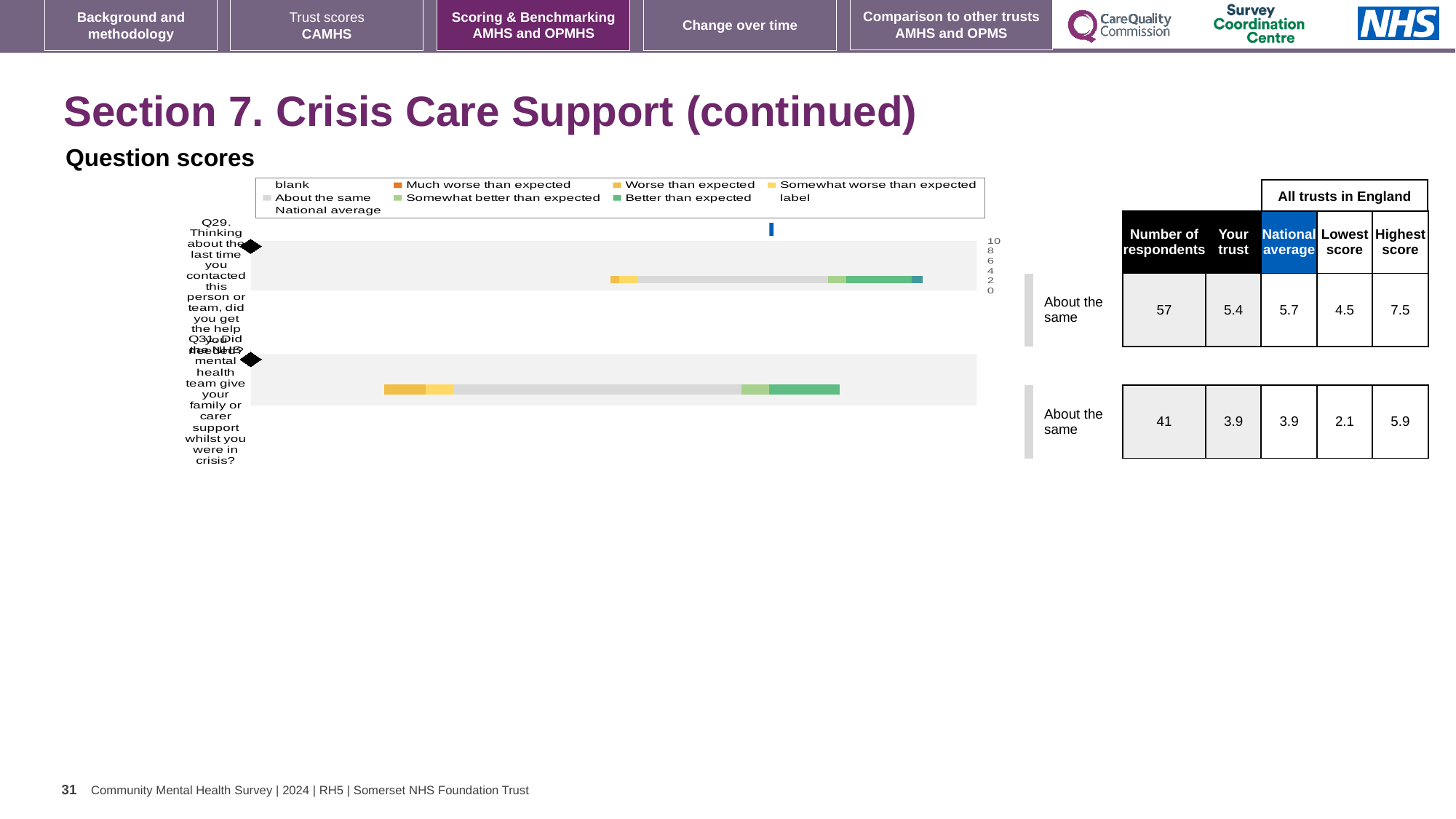
Which question is plotted in the bottom bar of the Question scores chart? Q31 How many questions (categories) are plotted in the Question scores chart? 2 In the Question scores chart legend, what colour represents 'Better than expected'? green Which question is plotted in the top bar of the Question scores chart? Q29 What kind of chart is shown under 'Question scores'? bar chart In the Question scores chart legend, what colour represents 'Much worse than expected'? orange How many entries does the legend of the Question scores chart list? 9